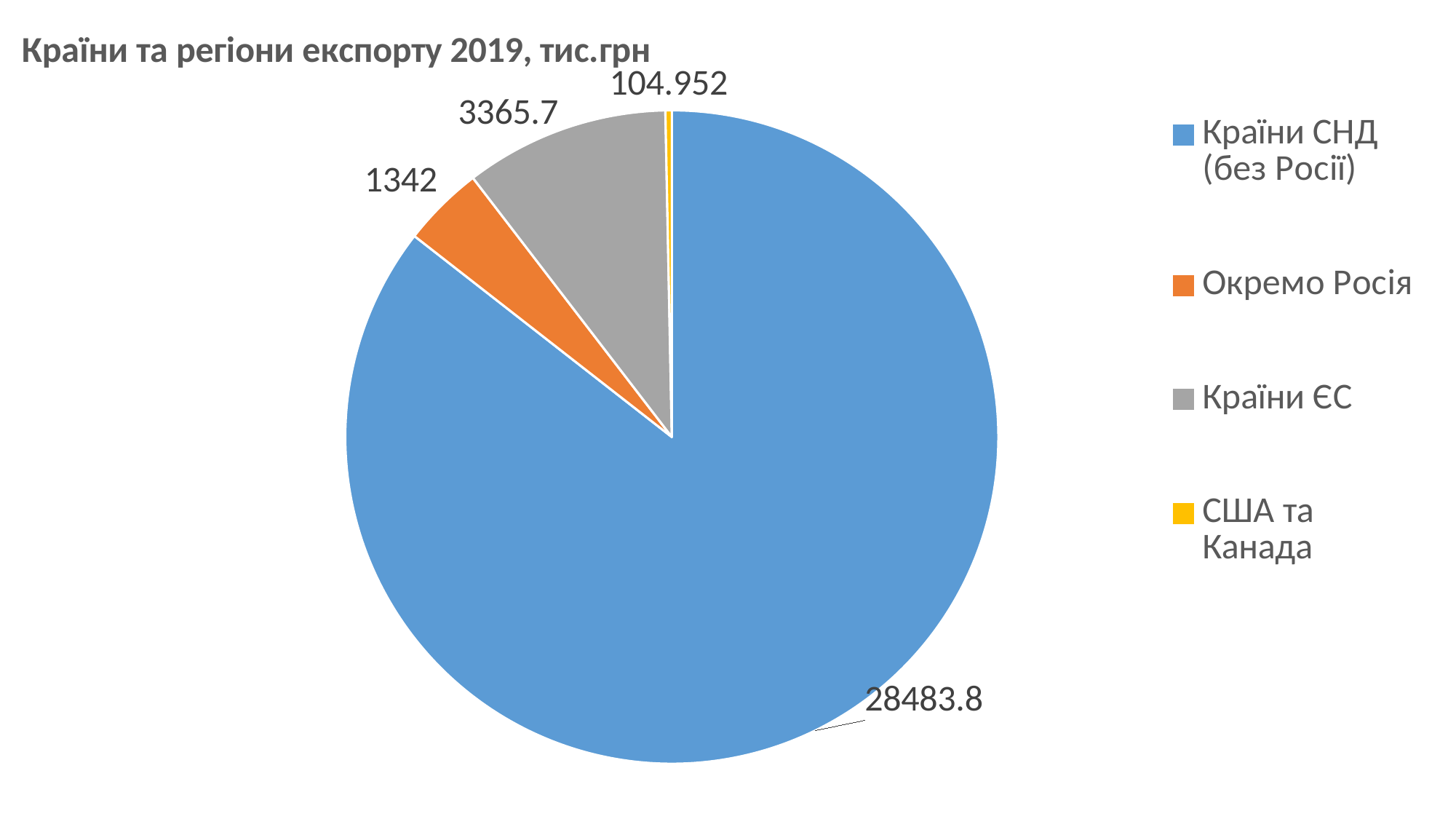
What is the value for США та Канада? 104.952 What is the difference between the values for Країни ЄС and Окремо Росія? 2023.7 Which is larger, Країни ЄС or Окремо Росія? Країни ЄС What colour is the slice for Окремо Росія? Orange What is the title of the chart? Країни та регіони експорту 2019, тис.грн What type of chart is shown on the slide? Pie chart Which category has the largest slice? Країни СНД (без Росії) What is the value for Окремо Росія? 1342 What is the value for Країни СНД (без Росії)? 28483.8 Which category has the smallest slice? США та Канада What is the value for Країни ЄС? 3365.7 How many slices does the pie chart have? 4